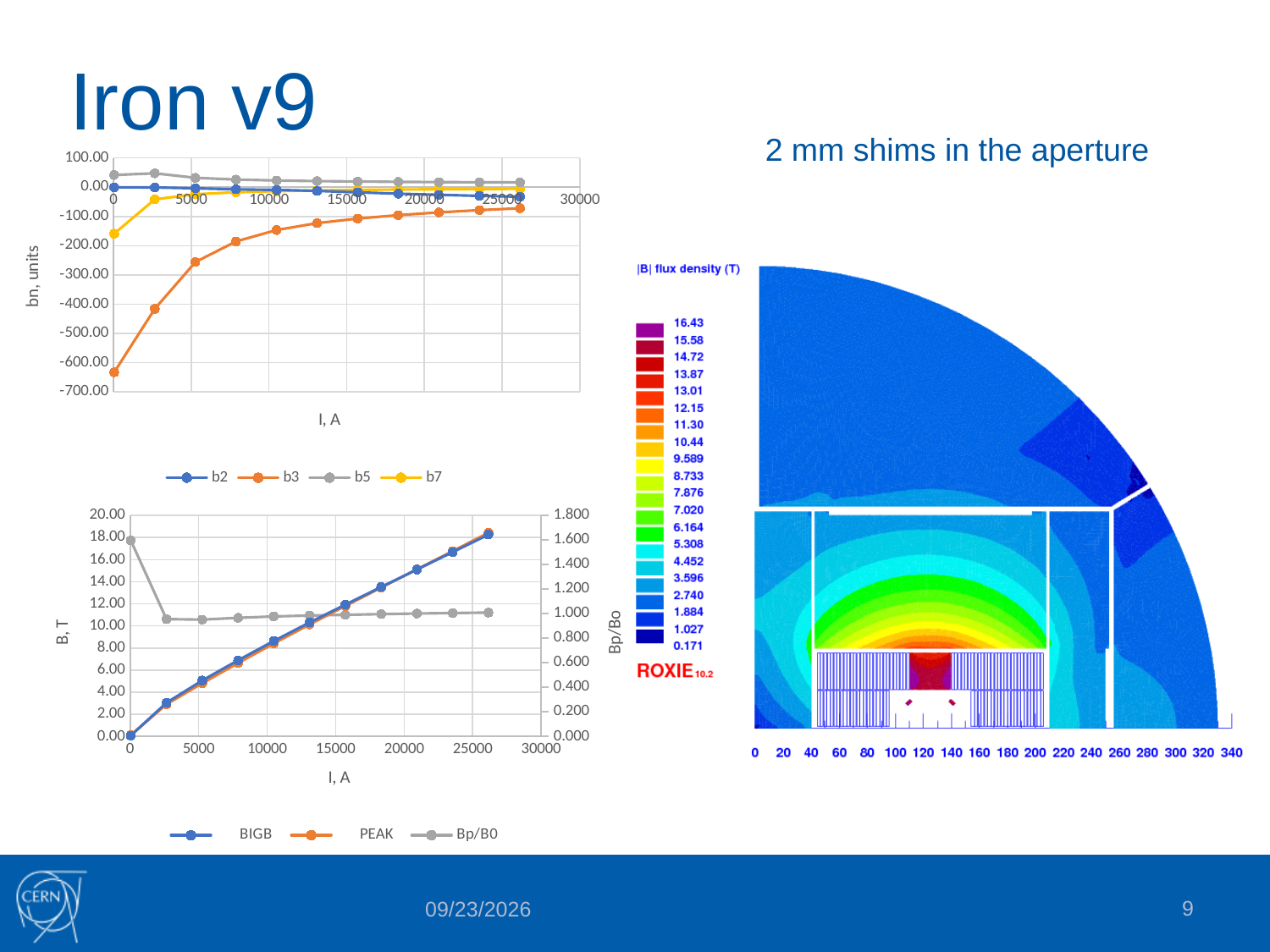
In the bottom-left chart, does the BIGB series rise or fall as I increases? rise In the top-left chart, does the b3 series rise or fall as I increases? rise In the bottom-left chart, is the BIGB value at I = 25000 greater or less than 16.00? greater In the top-left chart, at I = 0, which is larger, b3 or b7? b7 In the bottom-left chart, is the Bp/B0 value at I = 0 (right axis) greater or less than 1.400? greater What type of chart is the top-left chart with series b2, b3, b5 and b7? line chart In the top-left chart, which series has the lowest value at I = 0? b3 How many series does the legend of the top-left chart (bn, units vs I, A) list? 4 How many series does the legend of the bottom-left chart (B, T vs I, A) list? 3 What is the x-axis title of the bottom-left chart? I, A In the top-left chart, is the value of b3 at I = 0 greater or less than -600.00? less